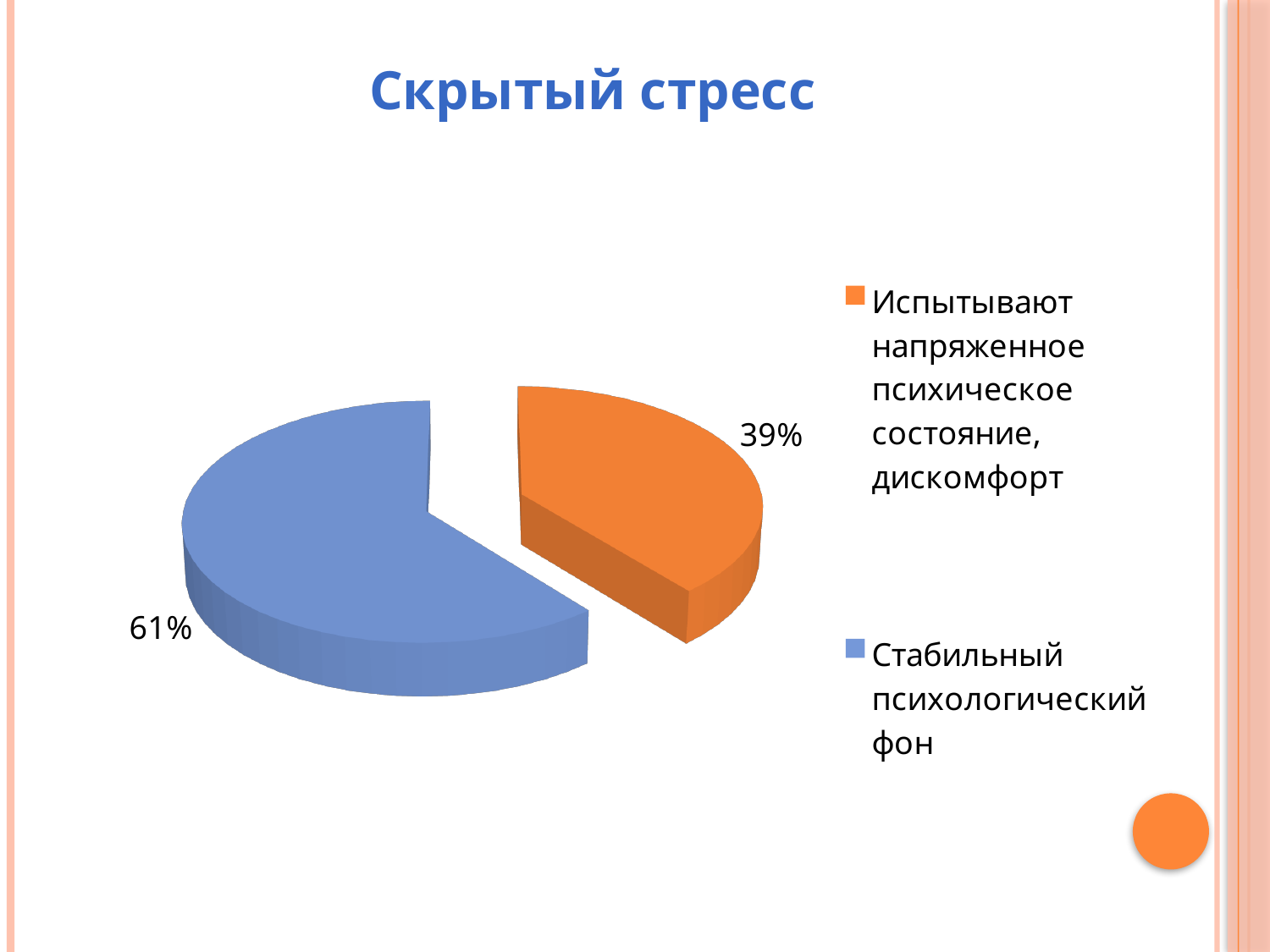
What kind of chart is shown on the slide? Pie chart What is the difference in percentage points between the "Стабильный психологический фон" slice and the "Испытывают напряженное психическое состояние, дискомфорт" slice? 22 Which category has the smallest slice of the pie? Испытывают напряженное психическое состояние, дискомфорт How many slices does the pie chart have? 2 What share of the pie is labelled "Испытывают напряженное психическое состояние, дискомфорт"? 39% How many entries does the legend list? 2 What share of the pie is labelled "Стабильный психологический фон"? 61% What colour is the slice for "Испытывают напряженное психическое состояние, дискомфорт"? Orange Which category has the largest slice of the pie? Стабильный психологический фон Is the share for "Стабильный психологический фон" greater or less than 50%? greater What is the title of the slide containing the pie chart? Скрытый стресс Which is larger: the slice for "Стабильный психологический фон" or the slice for "Испытывают напряженное психическое состояние, дискомфорт"? Стабильный психологический фон